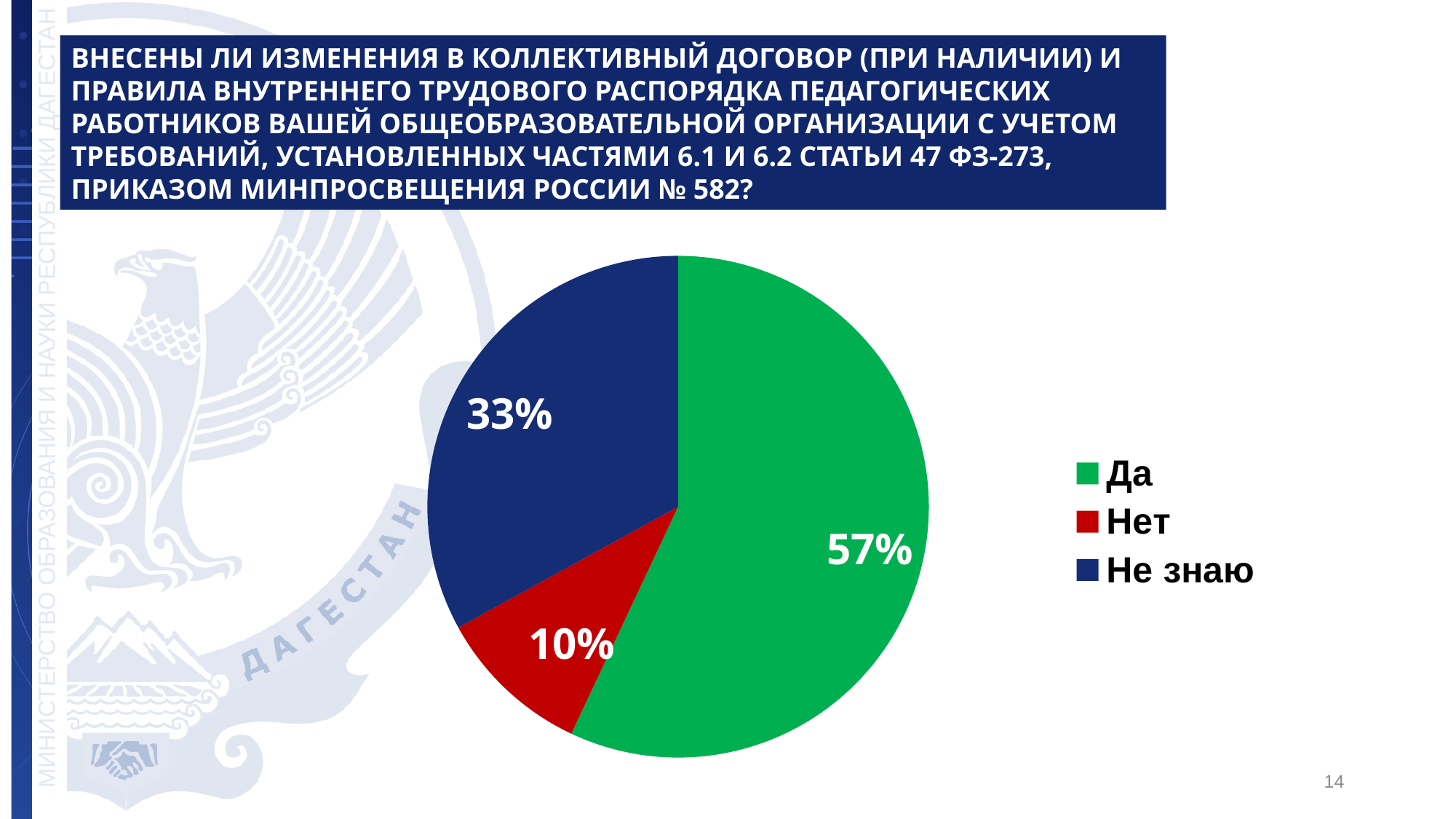
What share of the pie does the "Да" slice represent? 57% Which slice is larger, "Нет" or "Не знаю"? Не знаю Which legend entry is shown in red? Нет What share of the pie does the "Нет" slice represent? 10% Which category has the smallest slice of the pie? Нет What kind of chart is shown on the slide? Pie chart Which category has the largest slice of the pie? Да What is the difference in percentage points between the "Да" and "Не знаю" slices? 24 How many categories does the pie chart show? 3 What is the difference in percentage points between the "Не знаю" and "Нет" slices? 23 What share of the pie does the "Не знаю" slice represent? 33% What colour is the "Да" slice in the pie chart? Green